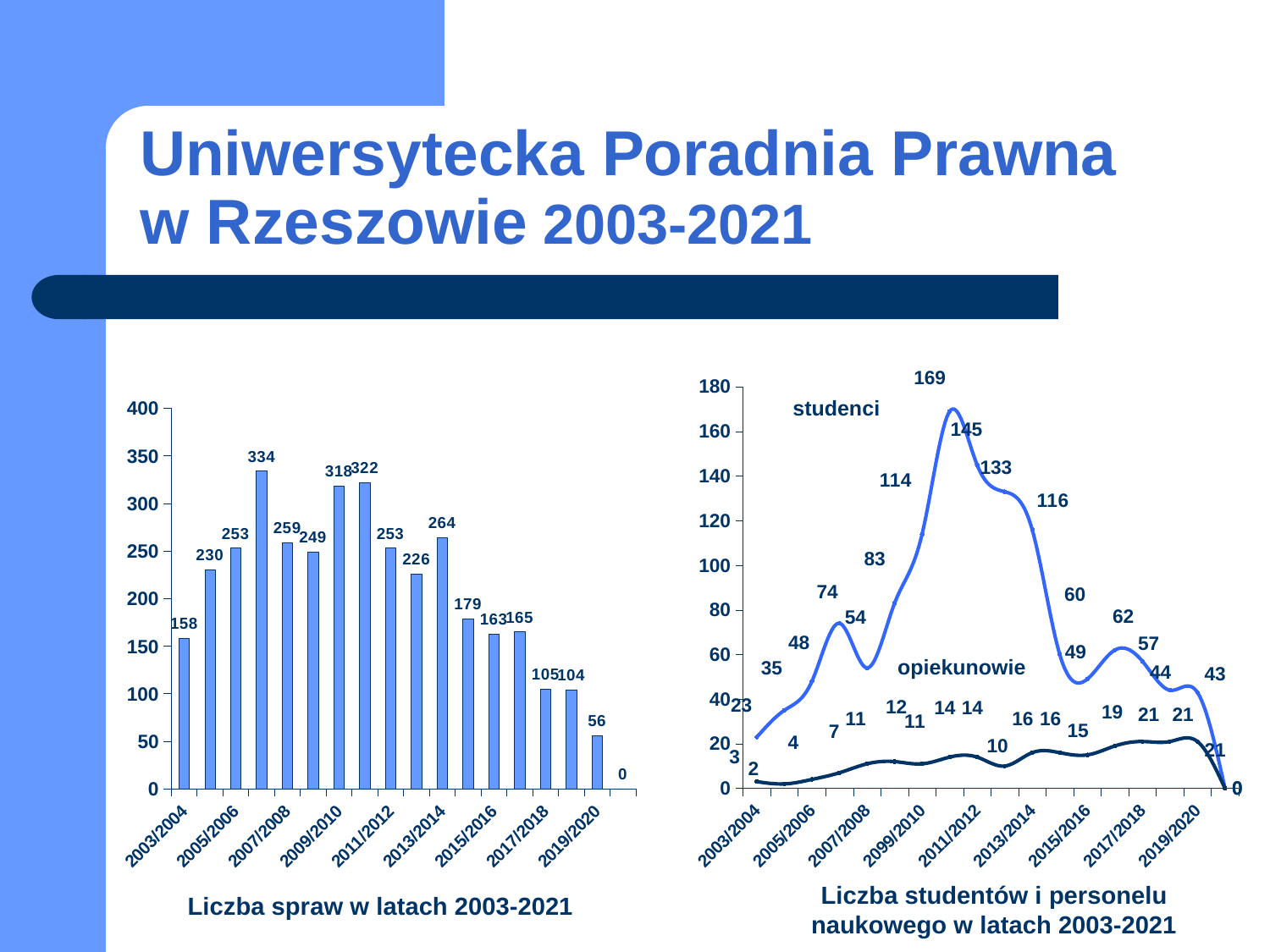
In the left chart, what is the highest value shown? 334 In the left chart, which is larger, the value for 2013/2014 or the value for 2011/2012? 2013/2014 What kind of chart is the right chart, 'Liczba studentów i personelu naukowego w latach 2003-2021'? line chart In the left chart, what is the value for 2003/2004? 158 In the left chart, what is the difference between the values for 2009/2010 and 2003/2004? 160 In the left chart, do the values rise or fall from 2013/2014 to 2019/2020? fall What kind of chart is the left chart, 'Liczba spraw w latach 2003-2021'? bar chart In the right chart, how many series are plotted? 2 In the right chart, what is the highest value of the 'studenci' series? 169 In the right chart, what is the value of 'opiekunowie' for 2003/2004? 3 In the left chart, what is the value for 2019/2020? 56 In the right chart, what are the names of the two series? studenci and opiekunowie